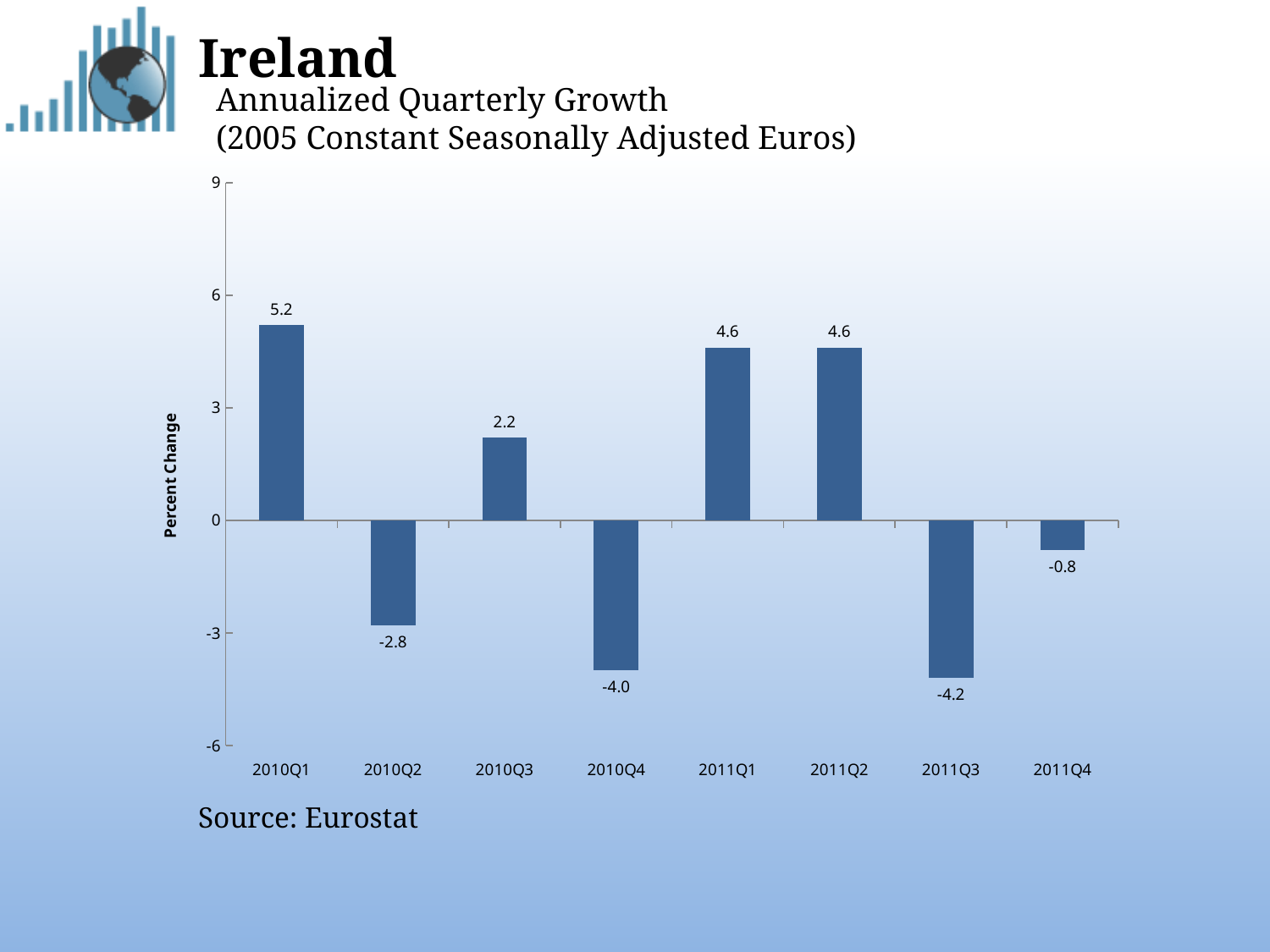
What is the value shown for 2011Q3? -4.2 Which quarter has the lowest annualized growth? 2011Q3 What kind of chart is shown on the slide? bar chart Is the value for 2010Q4 greater or less than -3? less What is the label on the vertical axis? Percent Change How many quarters are plotted on the chart? 8 Which quarter has the highest annualized growth? 2010Q1 What is the annualized quarterly growth value for 2010Q1? 5.2 What is the difference between the values for 2010Q1 and 2010Q3? 3.0 What is the source cited for the chart data? Eurostat Which is larger, the value for 2010Q3 or the value for 2011Q1? 2011Q1 What is the value shown for 2011Q4? -0.8